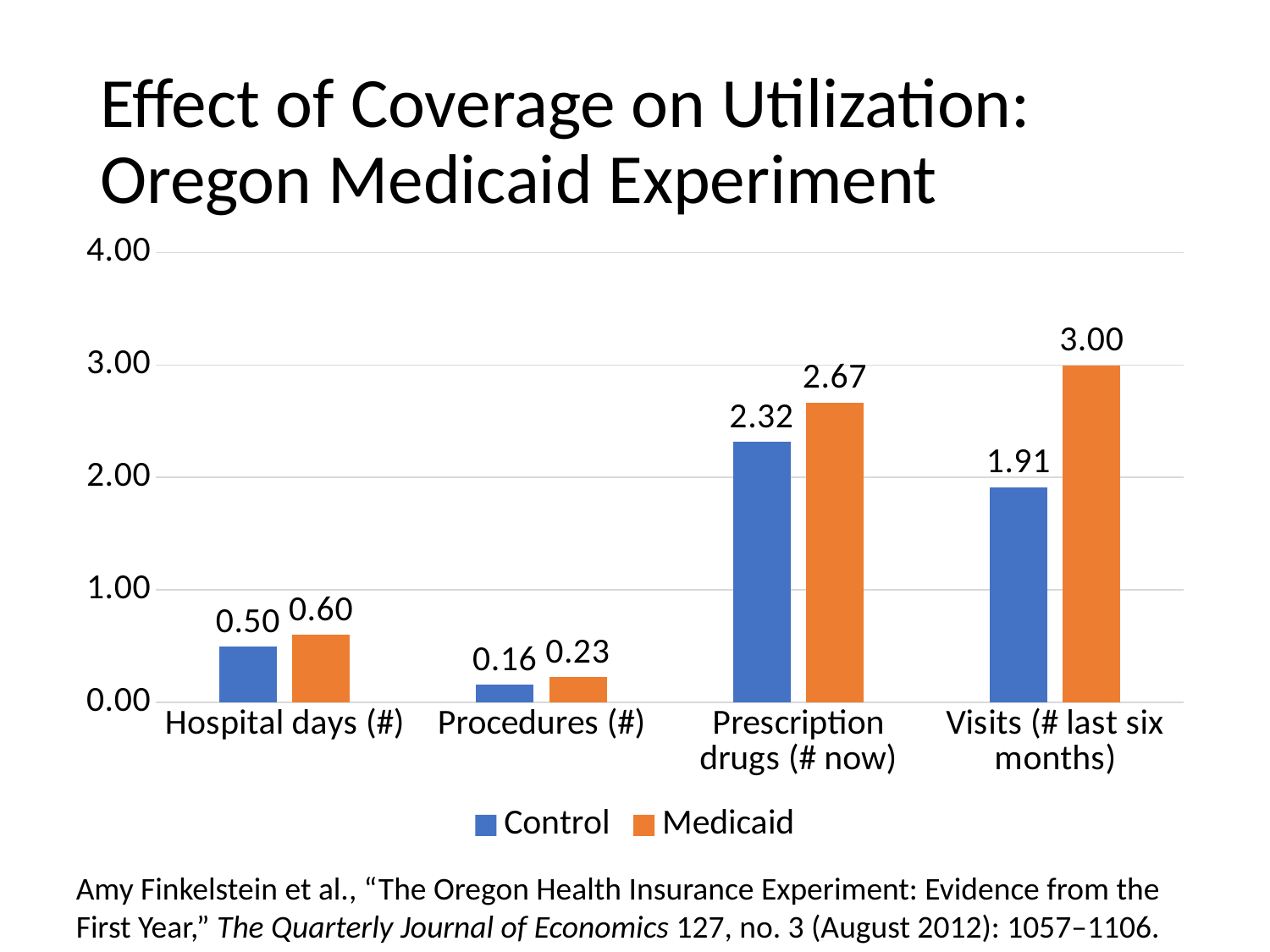
What kind of chart is shown on the slide? Bar chart Which is larger for Prescription drugs (# now): the Control value or the Medicaid value? Medicaid What is the difference between the Medicaid and Control values for Hospital days (#)? 0.10 What is the Medicaid value for Prescription drugs (# now)? 2.67 Is the Control value for Prescription drugs (# now) greater or less than 2.00? greater What is the Control value for Procedures (#)? 0.16 How many series does the legend list? 2 Which category has the highest Medicaid value? Visits (# last six months) Which category has the lowest Control value? Procedures (#) What is the difference between the Medicaid and Control values for Visits (# last six months)? 1.09 How many categories are shown on the x axis? 4 What is the Control value for Visits (# last six months)? 1.91